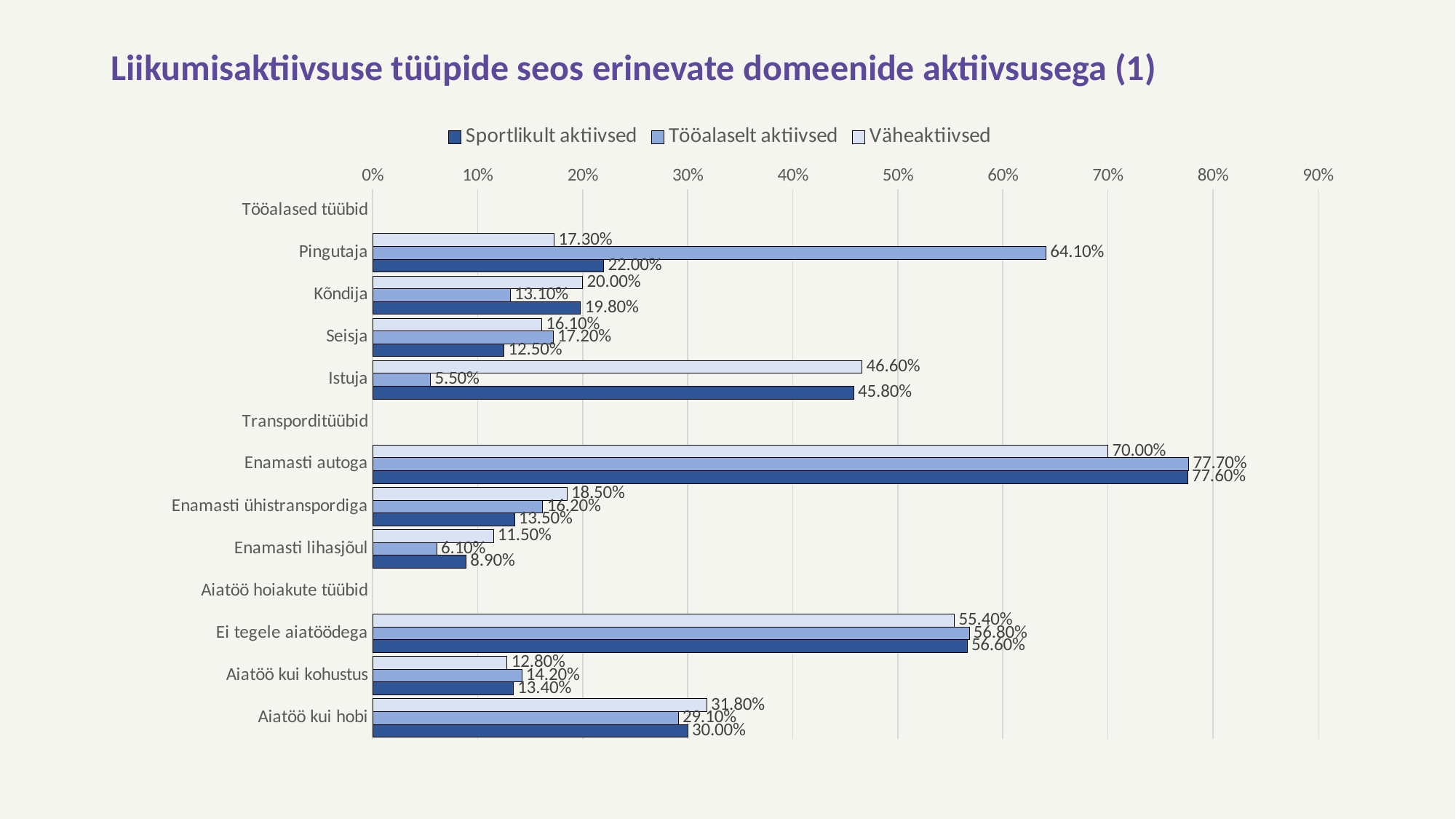
What is the value for Väheaktiivsed in the Enamasti autoga category? 70.00% Which category has the lowest value for the Tööalaselt aktiivsed series? Istuja What kind of chart is shown on the slide? bar chart Is the value for Sportlikult aktiivsed in the Ei tegele aiatöödega category greater or less than 50%? greater Which legend entry is shown with the darkest blue colour? Sportlikult aktiivsed What is the value for Tööalaselt aktiivsed in the Aiatöö kui hobi category? 29.10% What is the value for Sportlikult aktiivsed in the Istuja category? 45.80% For Enamasti lihasjõul, which is larger: the Väheaktiivsed value or the Sportlikult aktiivsed value? Väheaktiivsed What is the difference between the Väheaktiivsed and Tööalaselt aktiivsed values for Istuja? 41.10% How many series does the legend list? 3 What is the value for Tööalaselt aktiivsed in the Pingutaja category? 64.10% Which category has the highest value for the Tööalaselt aktiivsed series? Enamasti autoga